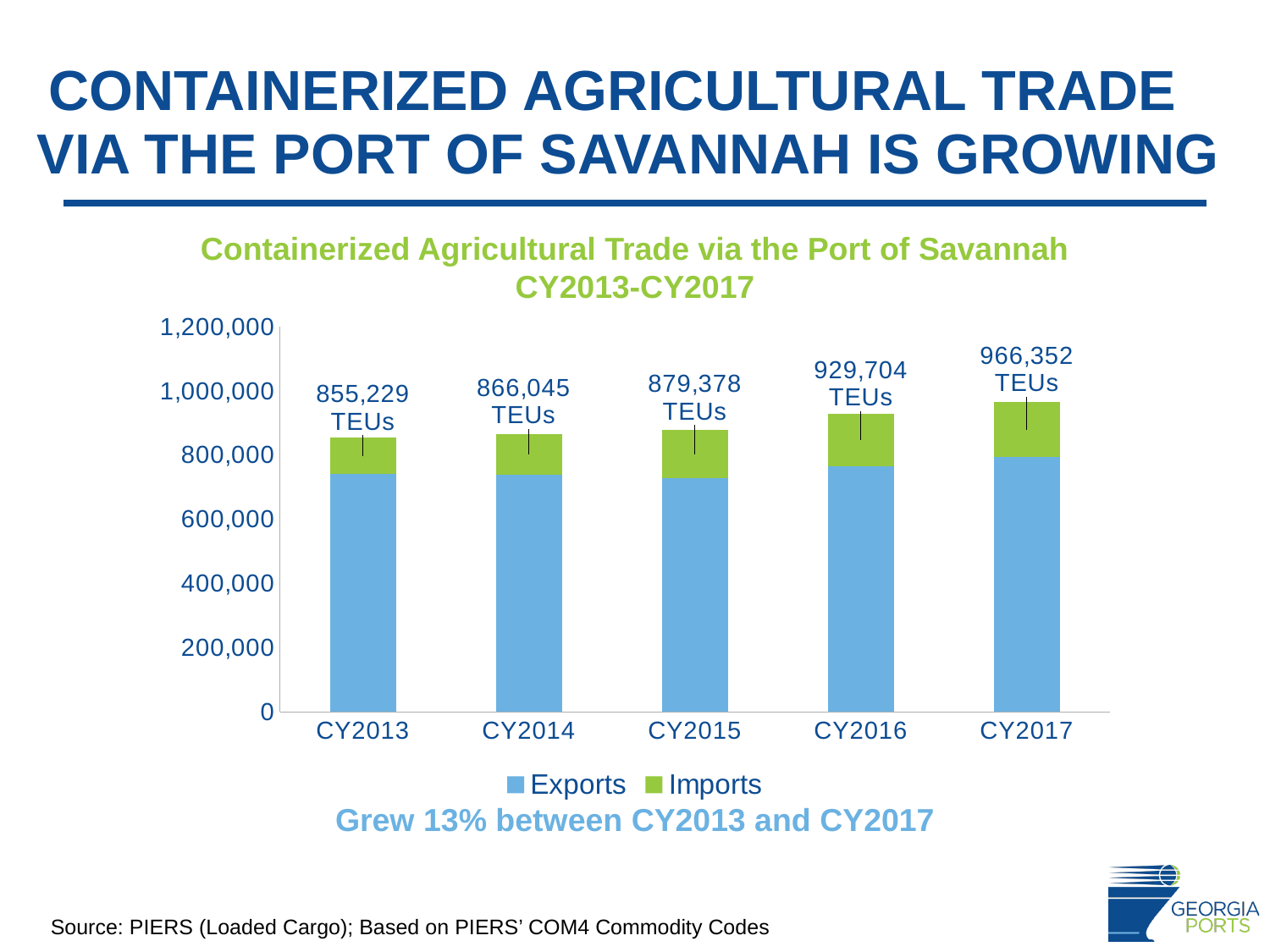
How many years are shown on the x axis? 5 What is the total containerized agricultural trade for CY2015? 879,378 TEUs What is the difference between the total for CY2017 and the total for CY2013? 111,123 TEUs What is the total of the stacked bar for CY2016? 929,704 TEUs What is the total containerized agricultural trade for CY2013? 855,229 TEUs Which year has the highest total containerized agricultural trade? CY2017 Is the value for Exports in CY2017 greater or less than 600,000? greater Which year has the lowest total containerized agricultural trade? CY2013 Which is larger, the total for CY2014 or the total for CY2016? CY2016 Do the total values rise or fall from CY2013 to CY2017? Rise What kind of chart is shown on the slide? Stacked bar chart How many series does the legend list? 2